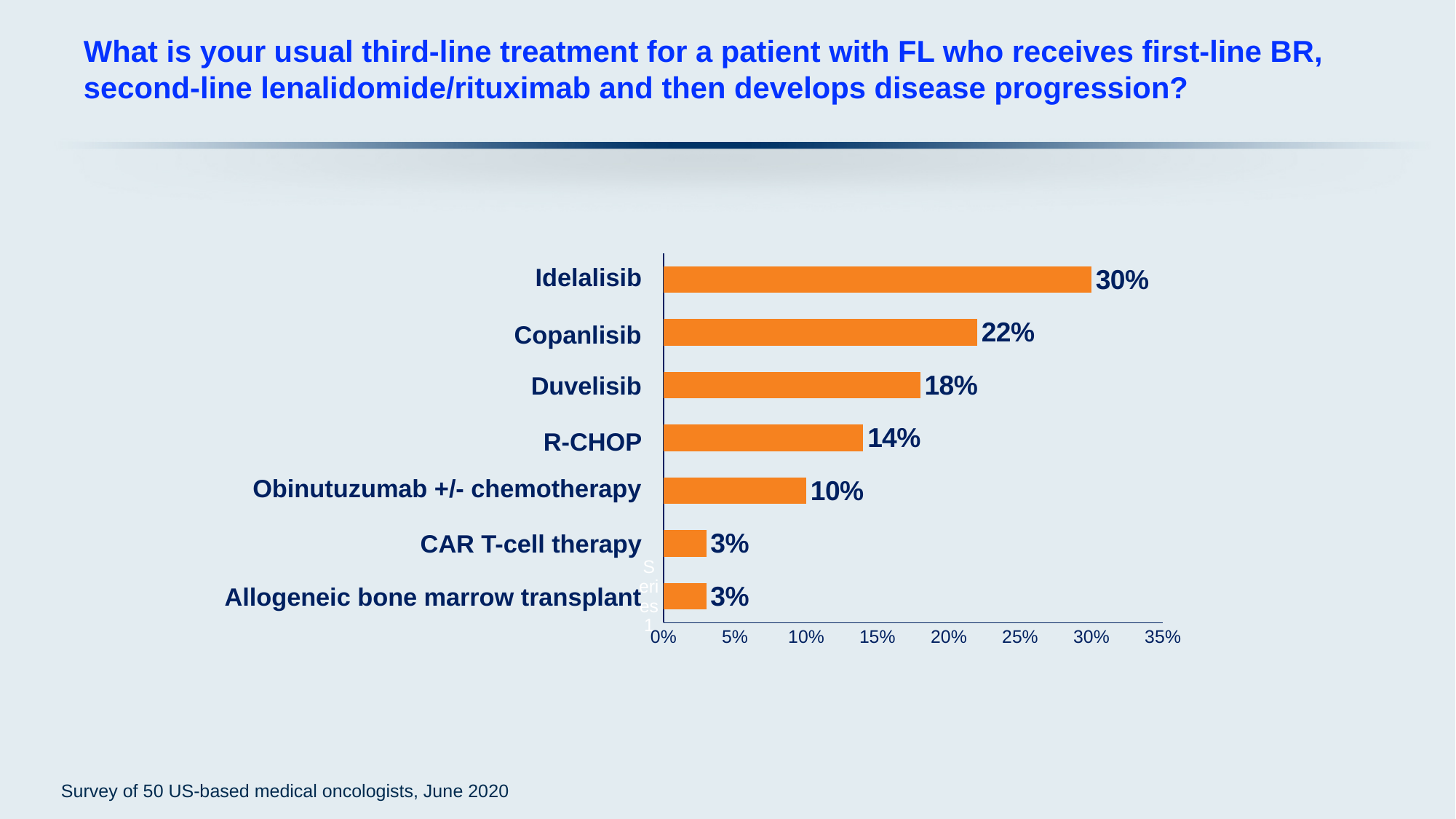
What kind of chart is shown on the slide? Bar chart What is the difference between the values for Duvelisib and R-CHOP? 4% Which has a larger value, Duvelisib or Obinutuzumab +/- chemotherapy? Duvelisib Is the value for Copanlisib greater or less than 20%? greater What percentage of respondents chose Idelalisib as their usual third-line treatment? 30% What is the value shown for Copanlisib? 22% What is the difference between the values for Idelalisib and Copanlisib? 8% What is the value for R-CHOP? 14% What is the maximum value shown on the horizontal axis? 35% Which treatment has the highest percentage? Idelalisib How many treatment categories are shown in the chart? 7 What percentage is shown for Obinutuzumab +/- chemotherapy? 10%